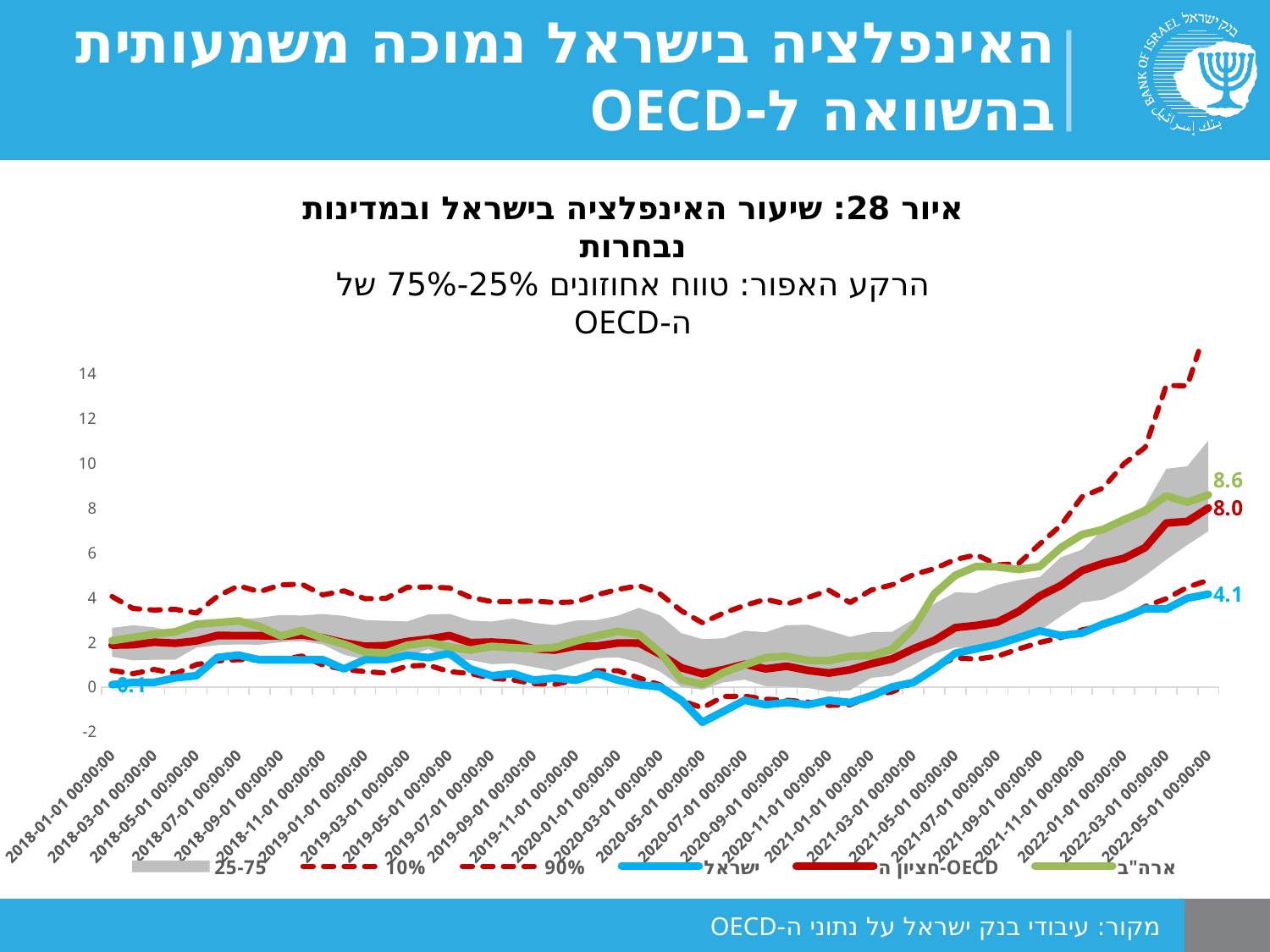
Which of the three labelled series (ישראל, חציון ה-OECD, ארה"ב) has the highest value at the end of the chart? ארה"ב Is the value of the 90% line at the end of the chart greater or less than 14? greater Does the ישראל line rise or fall between 2021-01-01 and 2022-05-01? Rise How many entries does the chart legend list? 6 What type of chart is shown on the slide? Line chart Which of the three labelled series (ישראל, חציון ה-OECD, ארה"ב) has the lowest value at the end of the chart? ישראל What is the difference between the latest labelled values for ארה"ב and ישראל? 4.5 What is the latest labelled value for חציון ה-OECD (OECD median) on the chart? 8.0 At the end of the series, which is higher: ישראל or ארה"ב? ארה"ב What is the latest labelled value for ישראל (Israel) on the chart? 4.1 What is the latest labelled value for ארה"ב (USA) on the chart? 8.6 What is the difference between the latest labelled values for חציון ה-OECD and ישראל? 3.9